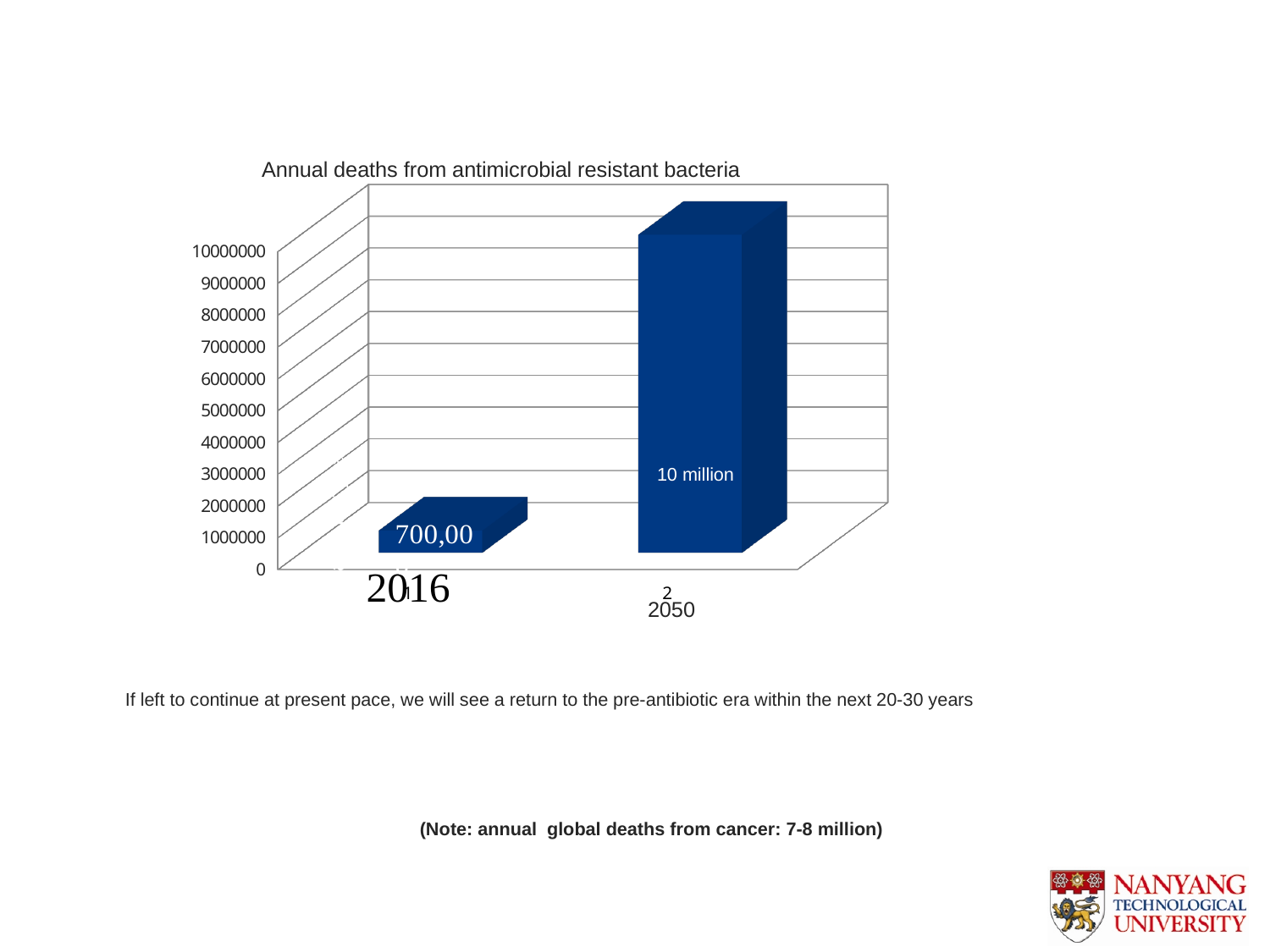
Which is larger, the value for 2016 or the value for 2050? 2050 What value is labelled on the bar for 2016? 700,00 Which year has the highest annual deaths in the chart? 2050 What value is labelled on the bar for 2050? 10 million What colour are the bars in the chart? blue What is the title of the chart? Annual deaths from antimicrobial resistant bacteria What kind of chart is shown on the slide? bar chart Do the values rise or fall from 2016 to 2050? rise Is the value for 2050 greater or less than 9000000? greater Which year has the lowest annual deaths in the chart? 2016 Is the value for 2016 greater or less than 2000000? less How many bars are plotted in the chart? 2